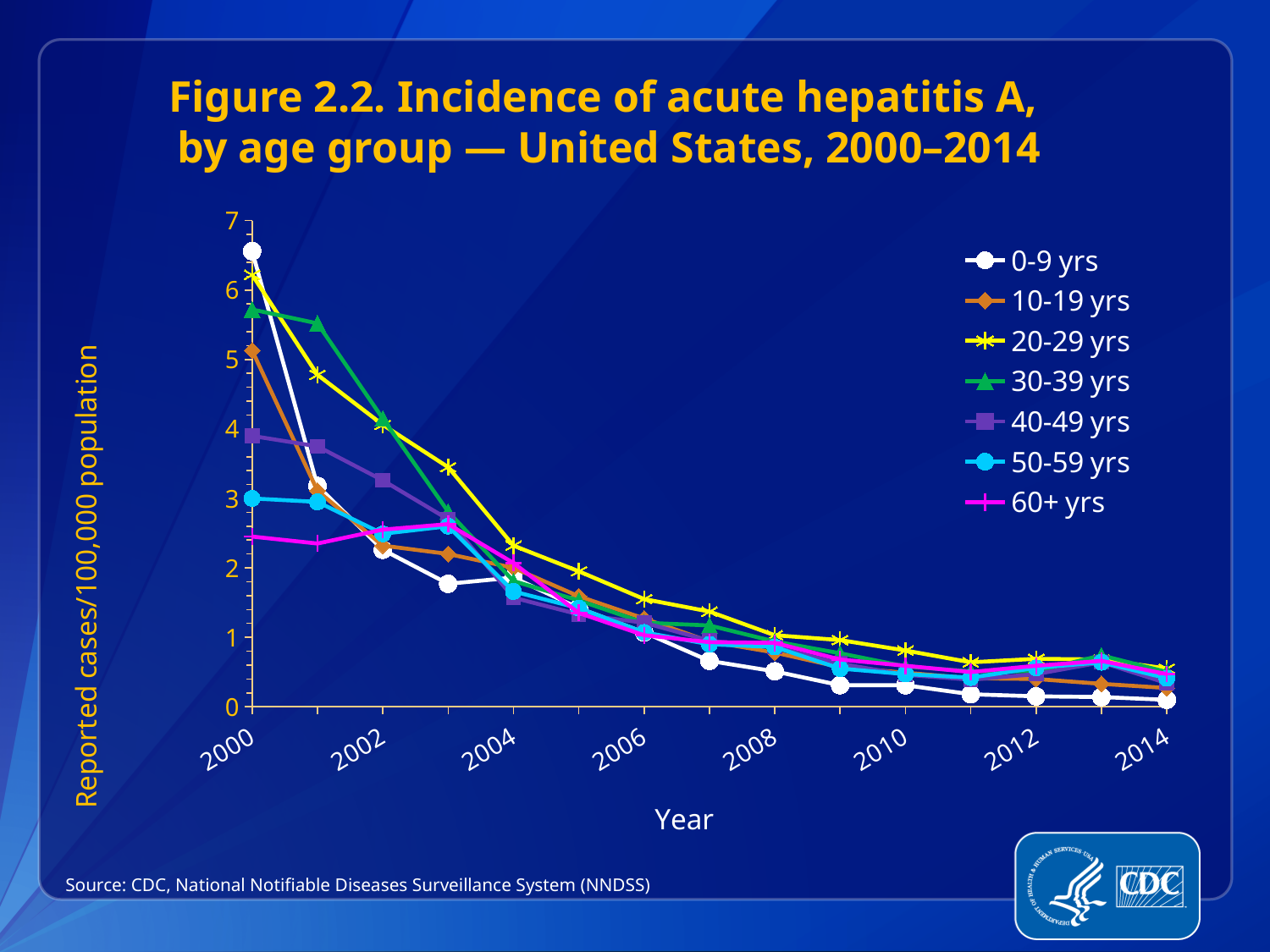
How many series does the legend list? 7 Is the value for 0-9 yrs in 2000 greater or less than 6? greater Is the value for 30-39 yrs in 2001 greater or less than 5? greater Which age group has the highest incidence in 2003? 20-29 yrs How many years (data points per series) does the chart cover, from 2000 to 2014? 15 Which age group has the lowest incidence in 2014? 0-9 yrs In 2004, which is larger: the value for 20-29 yrs or the value for 0-9 yrs? 20-29 yrs Is the value for 20-29 yrs in 2003 greater or less than 3? greater What kind of chart is shown on the slide? Line chart Does the incidence for 0-9 yrs rise or fall from 2000 to 2014? Fall Which age group has the lowest incidence in 2000? 60+ yrs